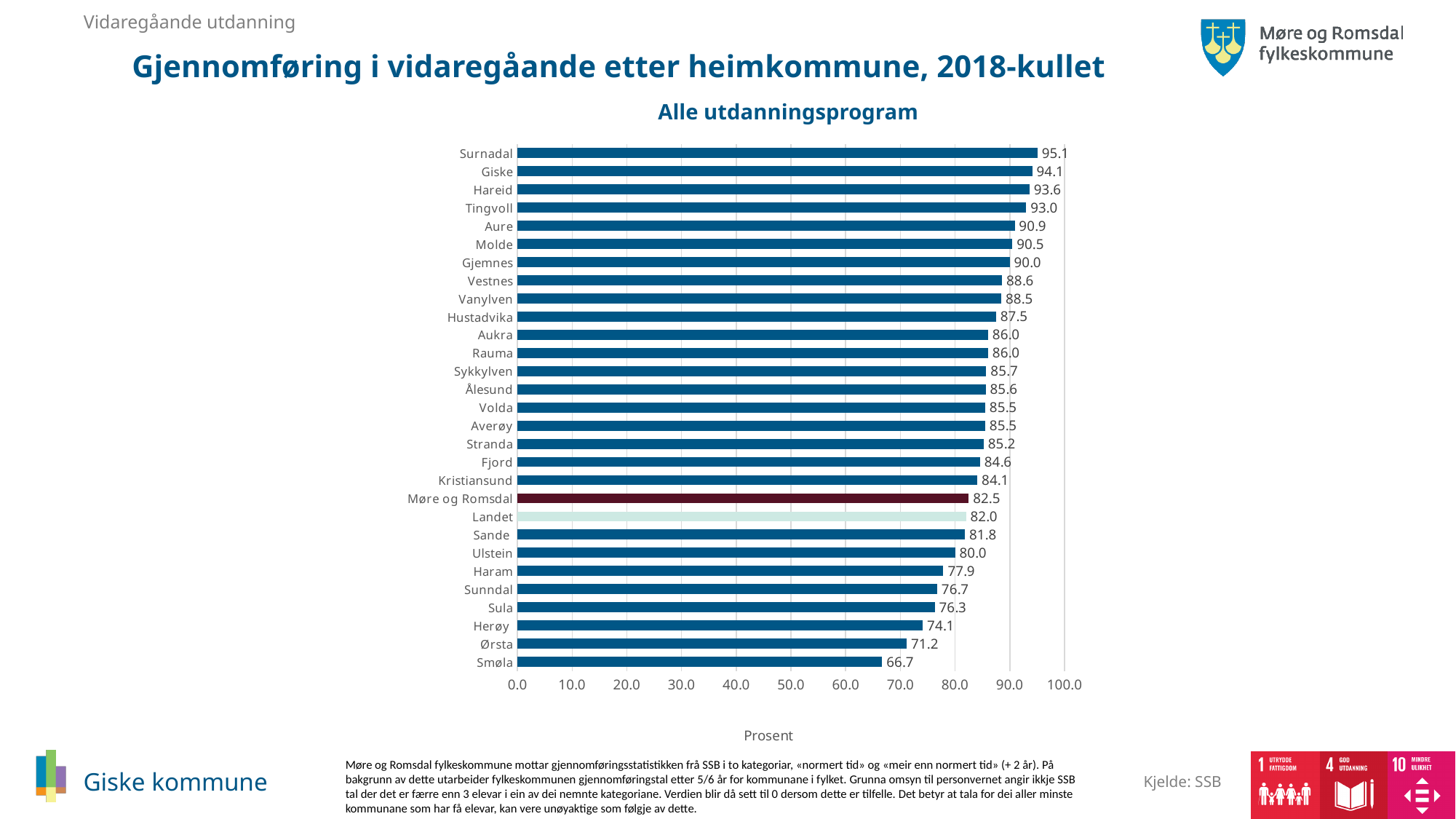
Is the value for Ørsta greater or less than 80.0? less What is the difference between the values for Giske and Landet? 12.1 How many bars are shown in the chart? 29 What is the difference between the values for Surnadal and Smøla? 28.4 Which municipality has the highest value? Surnadal What is the label on the horizontal axis of the chart? Prosent What is the value for Giske? 94.1 Which has a larger value, Molde or Ålesund? Molde Which municipality has the lowest value? Smøla What is the value for Landet? 82.0 What kind of chart is shown on the slide? Bar chart What is the value for Møre og Romsdal? 82.5